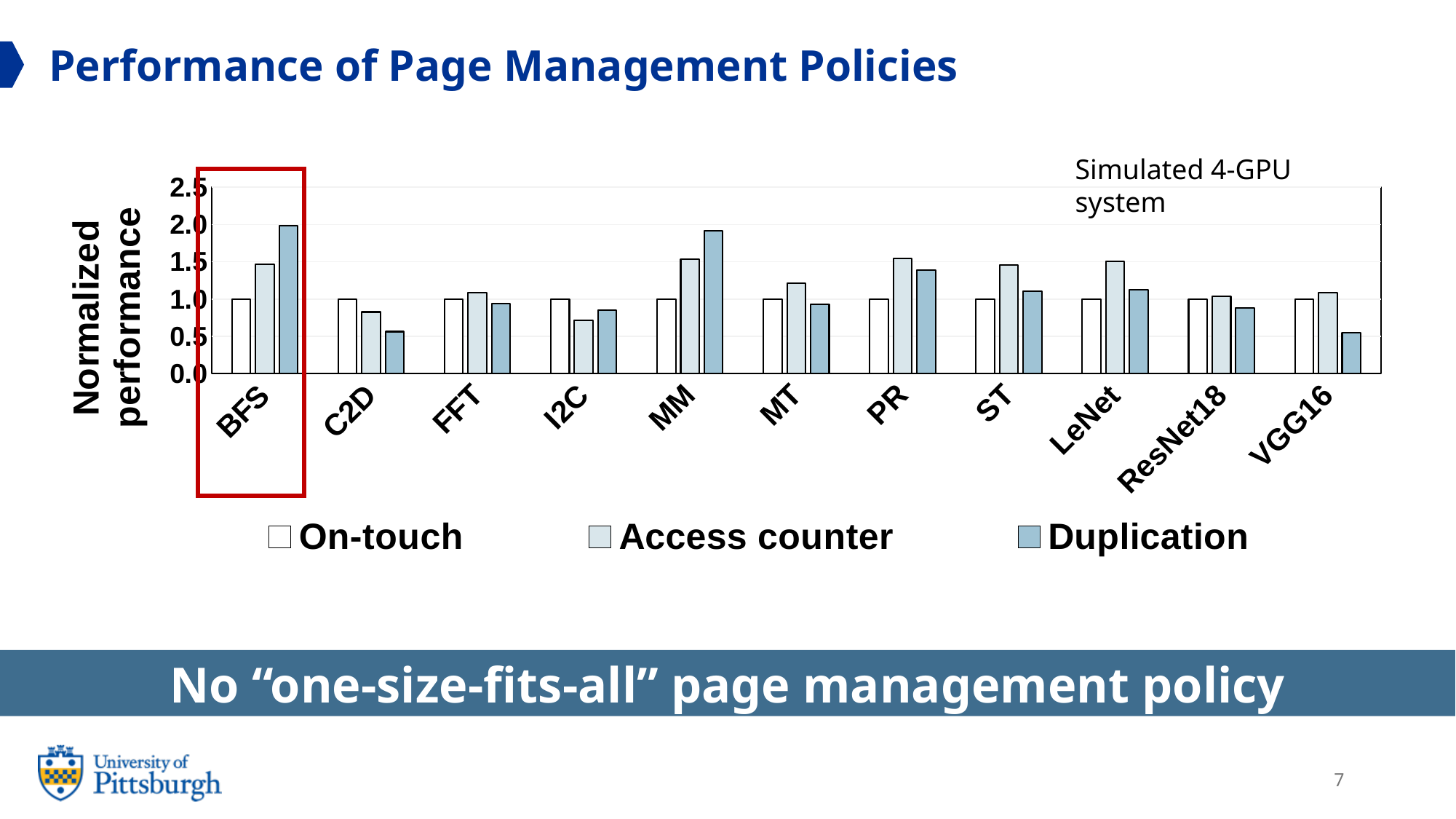
Is the Duplication value for BFS greater or less than 1.5? greater What kind of chart is shown on the slide? bar chart For I2C, which is larger: Access counter or Duplication? Duplication Is the Duplication value for C2D greater or less than 1.0? less For PR, which is larger: Access counter or Duplication? Access counter Is the Access counter value for LeNet greater or less than 1.0? greater Which benchmark is highlighted with a red box on the chart? BFS What is the normalized performance of On-touch for BFS? 1.0 For MM, which policy has the highest normalized performance? Duplication How many series does the legend list? 3 How many benchmark categories are shown on the x axis? 11